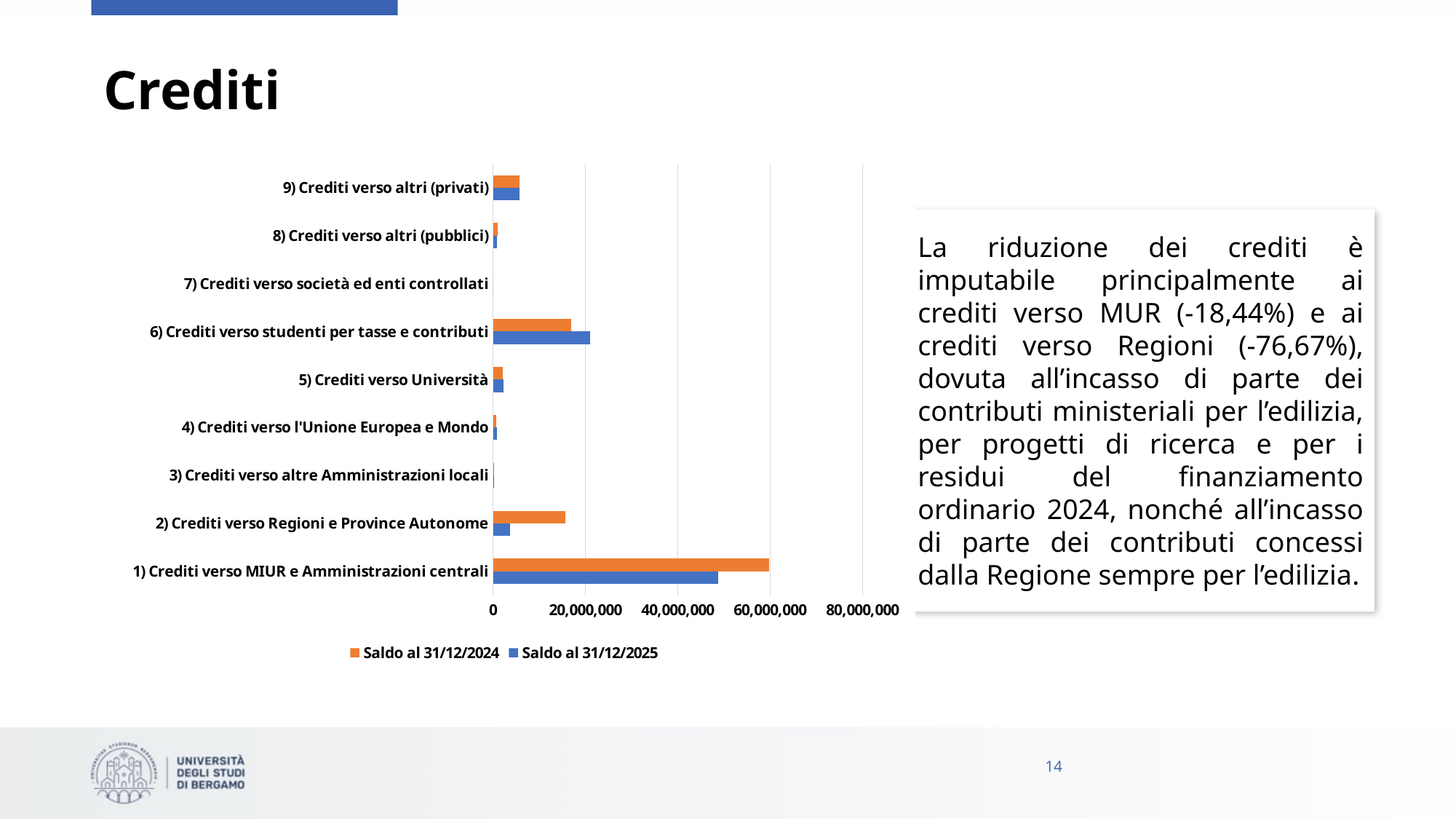
What kind of chart is shown on the slide? bar chart For 6) Crediti verso studenti per tasse e contributi, which is larger: Saldo al 31/12/2024 or Saldo al 31/12/2025? Saldo al 31/12/2025 For 2) Crediti verso Regioni e Province Autonome, which is larger: Saldo al 31/12/2024 or Saldo al 31/12/2025? Saldo al 31/12/2024 Is the Saldo al 31/12/2025 value for 2) Crediti verso Regioni e Province Autonome greater or less than 20,000,000? less Is the Saldo al 31/12/2024 value for 1) Crediti verso MIUR e Amministrazioni centrali greater or less than 40,000,000? greater Which category has the highest value for Saldo al 31/12/2024? 1) Crediti verso MIUR e Amministrazioni centrali How many categories of crediti are shown on the chart? 9 What is the highest value shown on the chart's horizontal axis? 80,000,000 Which colour represents Saldo al 31/12/2025 in the chart? blue Is the Saldo al 31/12/2025 value for 1) Crediti verso MIUR e Amministrazioni centrali greater or less than 60,000,000? less Which category has the highest value for Saldo al 31/12/2025? 1) Crediti verso MIUR e Amministrazioni centrali How many series does the chart legend list? 2